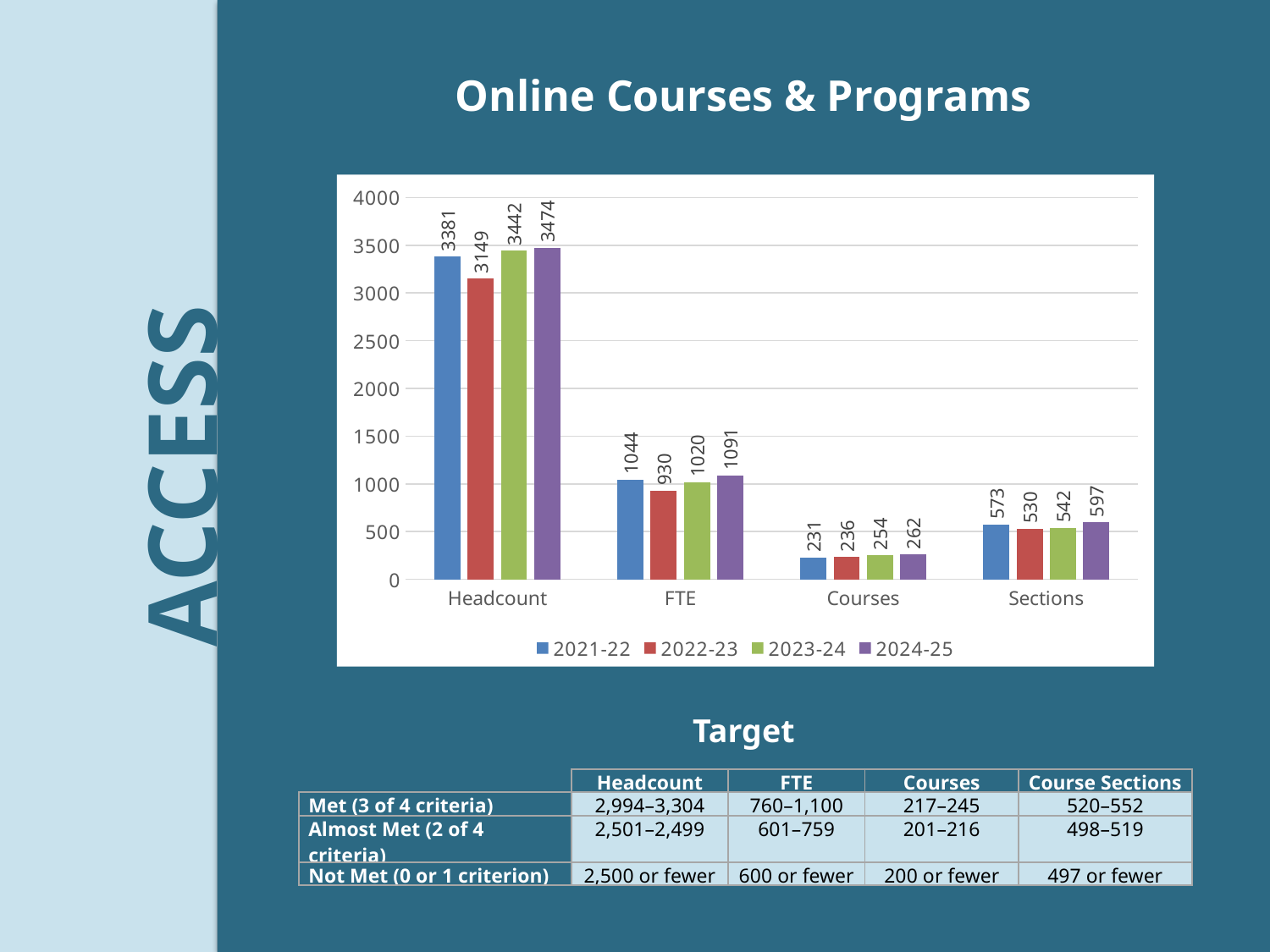
What is the Sections value for 2023-24? 542 What kind of chart is shown? bar chart What is the FTE value for 2022-23? 930 What is the Courses value for 2021-22? 231 What is the title of the slide containing the chart? Online Courses & Programs Which year has the lowest FTE? 2022-23 Which year has the highest Headcount? 2024-25 What is the difference between the Headcount for 2024-25 and 2022-23? 325 Which is larger, the Sections value for 2021-22 or for 2023-24? 2021-22 How many series does the legend list? 4 How many categories are shown on the x axis? 4 What is the Headcount value for 2024-25? 3474